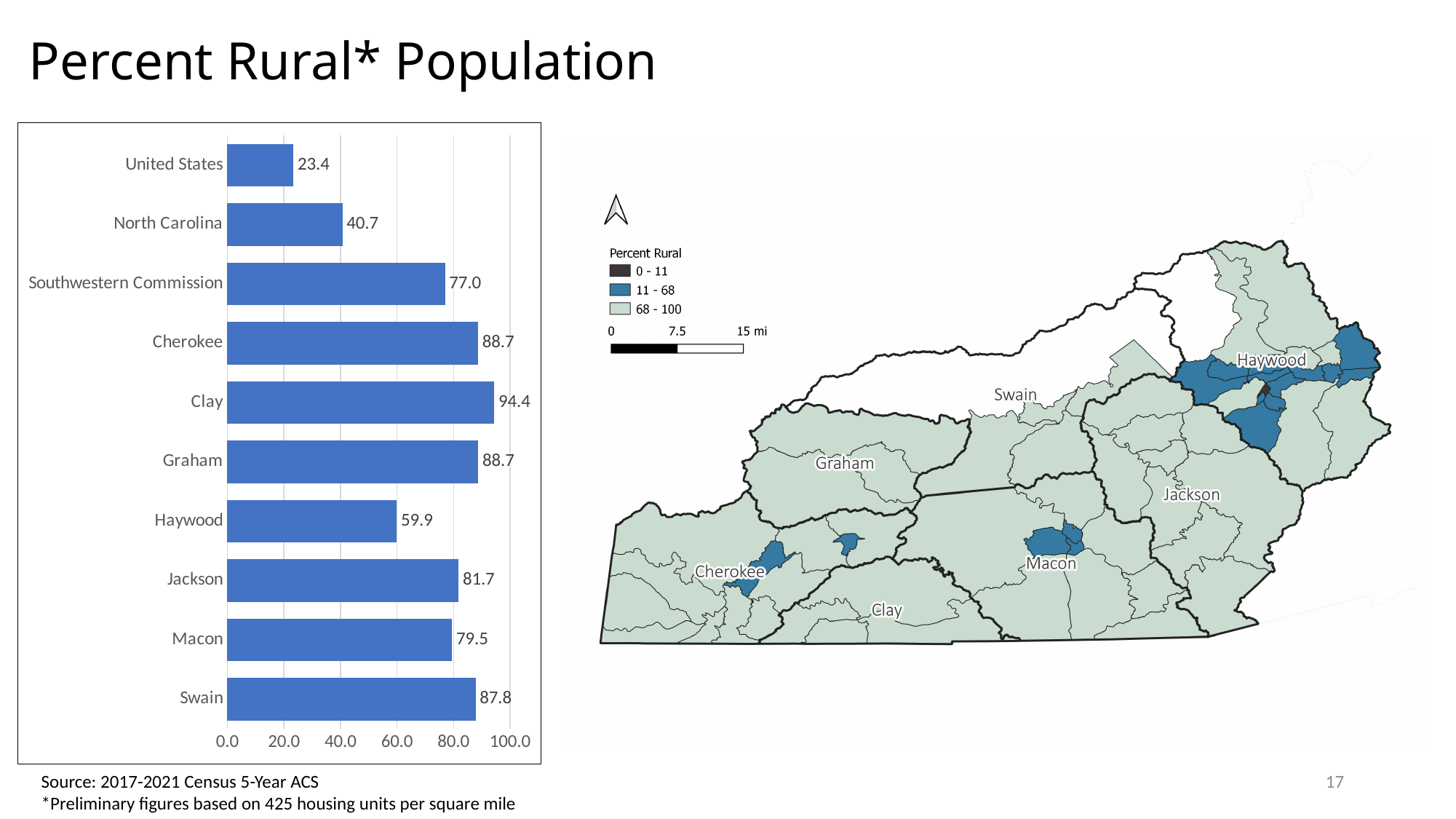
What is the value shown for Haywood in the bar chart? 59.9 What is the maximum value shown on the x axis of the bar chart? 100.0 What is the value shown for the Southwestern Commission in the bar chart? 77.0 What is the value shown for the United States in the bar chart? 23.4 Which category has the highest value in the bar chart? Clay What kind of chart is shown on the left of the slide? Bar chart Which category has the lowest value in the bar chart? United States How many categories are shown in the bar chart? 10 What is the difference between the values for North Carolina and the United States in the bar chart? 17.3 Which has a larger value in the bar chart, Jackson or Macon? Jackson What is the difference between the values for Clay and Haywood in the bar chart? 34.5 What is the percent rural population value for Clay in the bar chart? 94.4